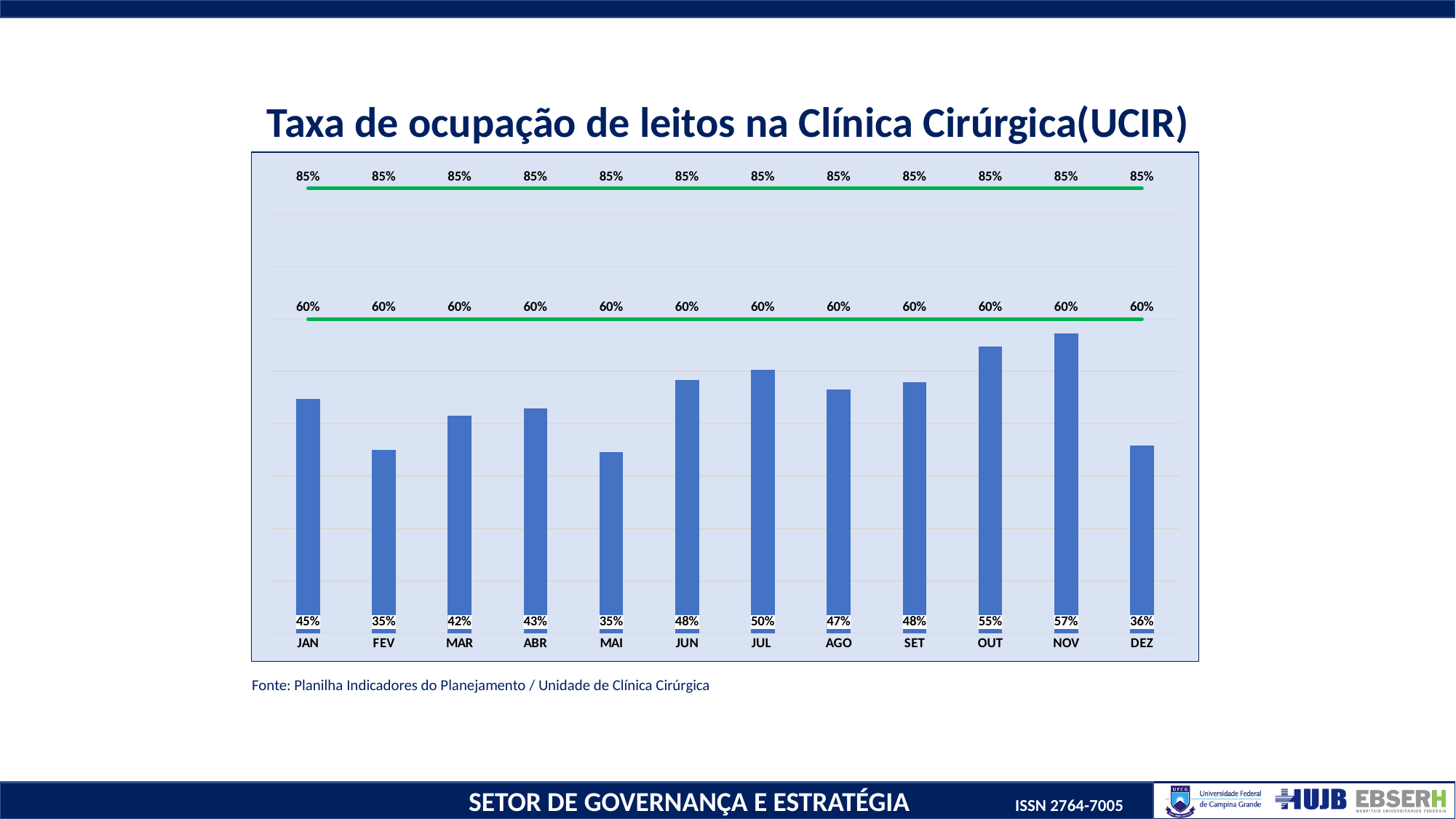
What is the difference between the occupancy rate in NOV and the occupancy rate in FEV? 22% What kind of chart is shown on the slide? bar chart Is the occupancy rate for OUT greater or less than 60%? less What is the bed occupancy rate for JAN? 45% Which is larger, the occupancy rate in JUN or the occupancy rate in AGO? JUN What is the title of the chart? Taxa de ocupação de leitos na Clínica Cirúrgica(UCIR) Which month has the highest bed occupancy rate? NOV What value does the upper green reference line show for every month? 85% Do the occupancy rates rise or fall from AGO to NOV? rise What is the bed occupancy rate for NOV? 57% What is the bed occupancy rate for DEZ? 36% How many months are shown on the x axis? 12